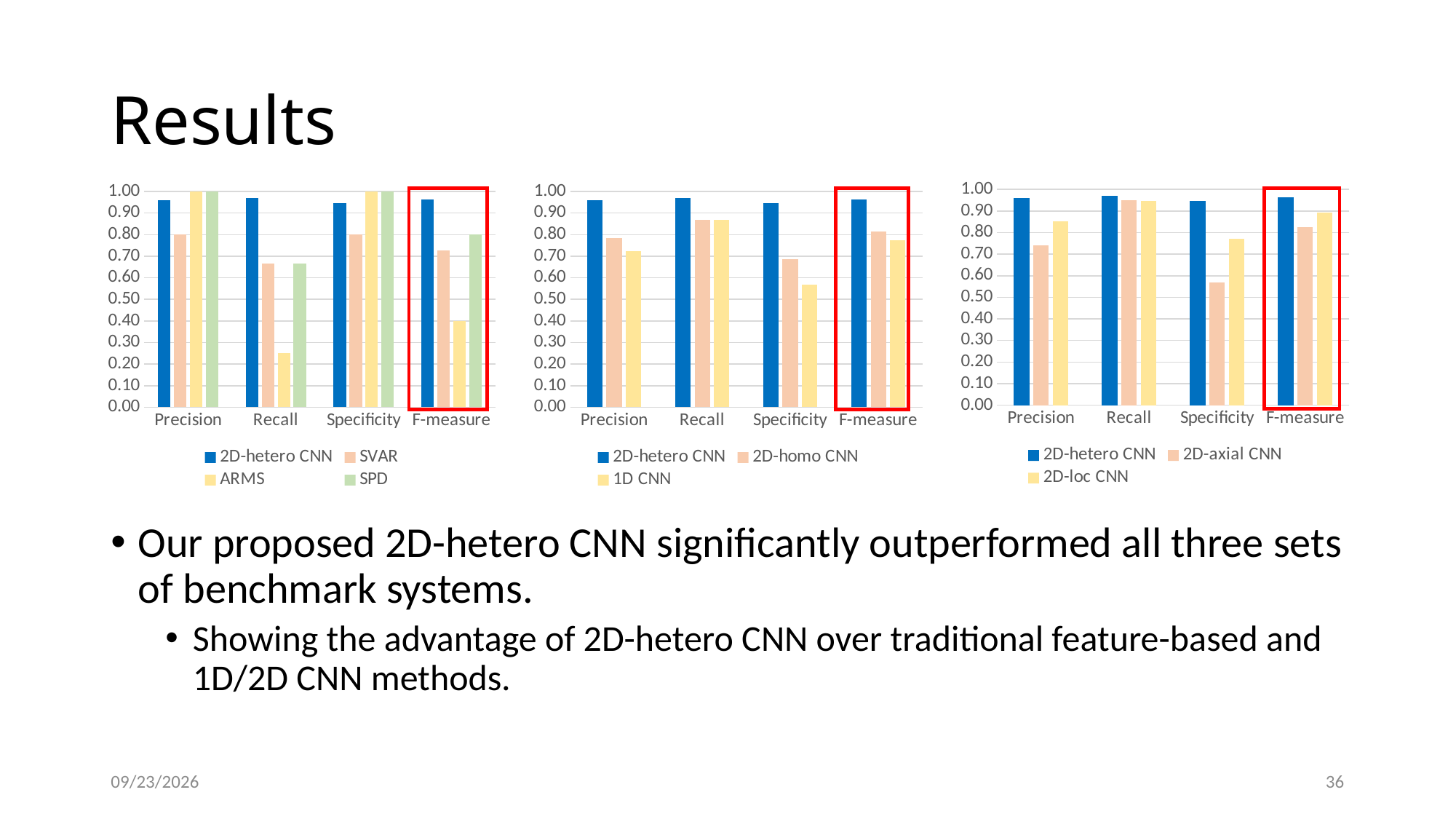
In the right chart, which is larger: the Specificity value for 2D-axial CNN or for 2D-loc CNN? 2D-loc CNN What kind of chart is the left chart on the slide? bar chart In the middle chart, is the Specificity value for 1D CNN greater or less than 0.60? less How many categories are shown on the x axis of the right chart? 4 How many series does the legend of the left chart list? 4 How many series does the legend of the middle chart list? 3 In the left chart, is the F-measure value for ARMS greater or less than 0.50? less In the left chart, which series has the lowest Recall value? ARMS Which series appears in the legend of all three charts? 2D-hetero CNN In the left chart, is the Recall value for ARMS greater or less than 0.30? less In the middle chart, which series has the lowest Specificity value? 1D CNN